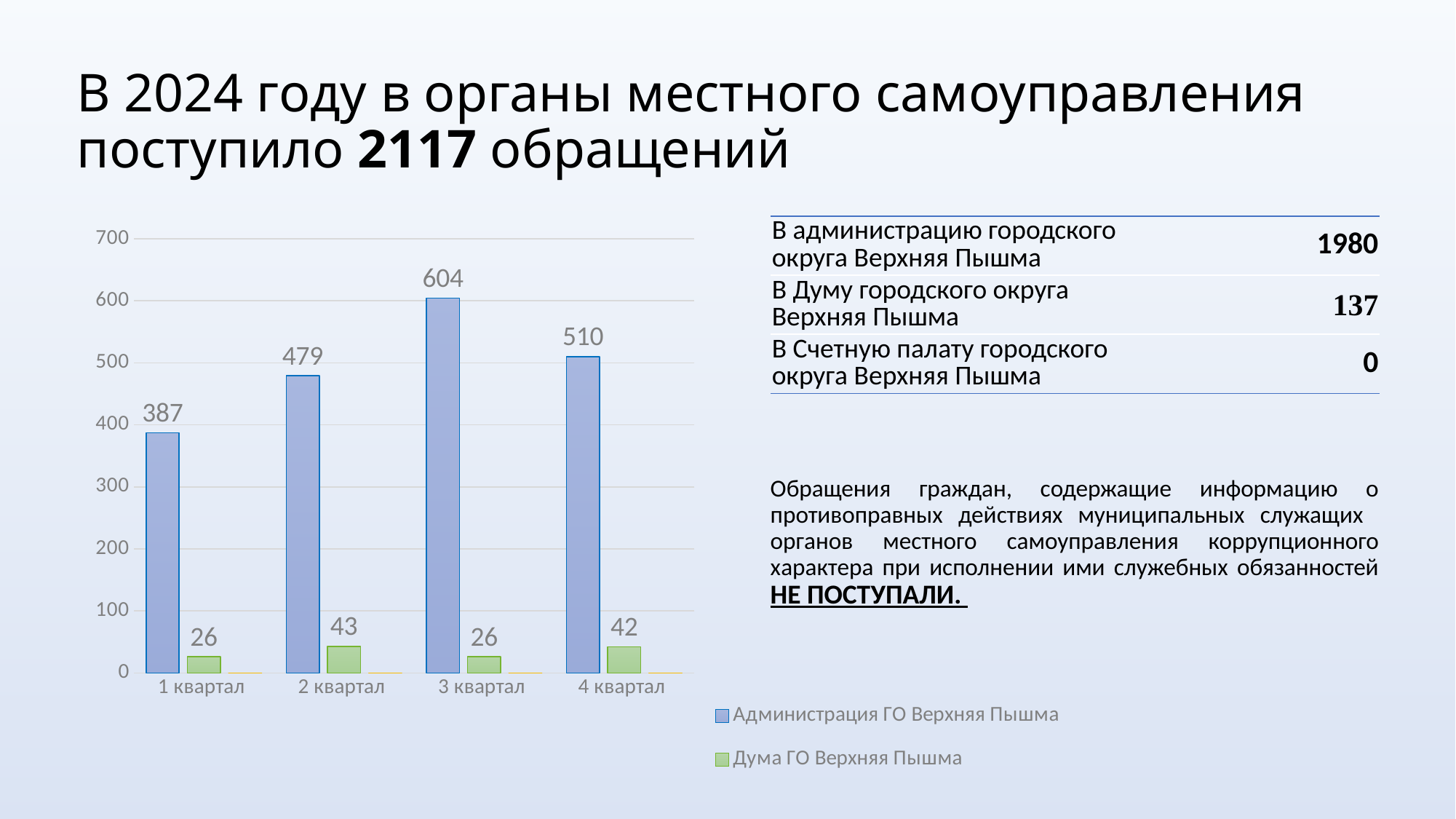
What is the difference between the Администрация ГО Верхняя Пышма values for 3 квартал and 2 квартал? 125 In which quarter is the value for Администрация ГО Верхняя Пышма the lowest? 1 квартал What is the value for Администрация ГО Верхняя Пышма in 3 квартал? 604 Which quarter has the larger value for Администрация ГО Верхняя Пышма: 2 квартал or 4 квартал? 4 квартал What is the difference between the Дума ГО Верхняя Пышма values for 2 квартал and 1 квартал? 17 What is the value for Дума ГО Верхняя Пышма in 2 квартал? 43 Do the values for Администрация ГО Верхняя Пышма rise or fall from 1 квартал to 3 квартал? rise What kind of chart is shown on the slide? bar chart How many series does the chart legend list? 2 In which quarter is the value for Администрация ГО Верхняя Пышма the highest? 3 квартал How many quarters are shown on the x axis of the chart? 4 Is the value for Администрация ГО Верхняя Пышма in 1 квартал greater or less than 400? less